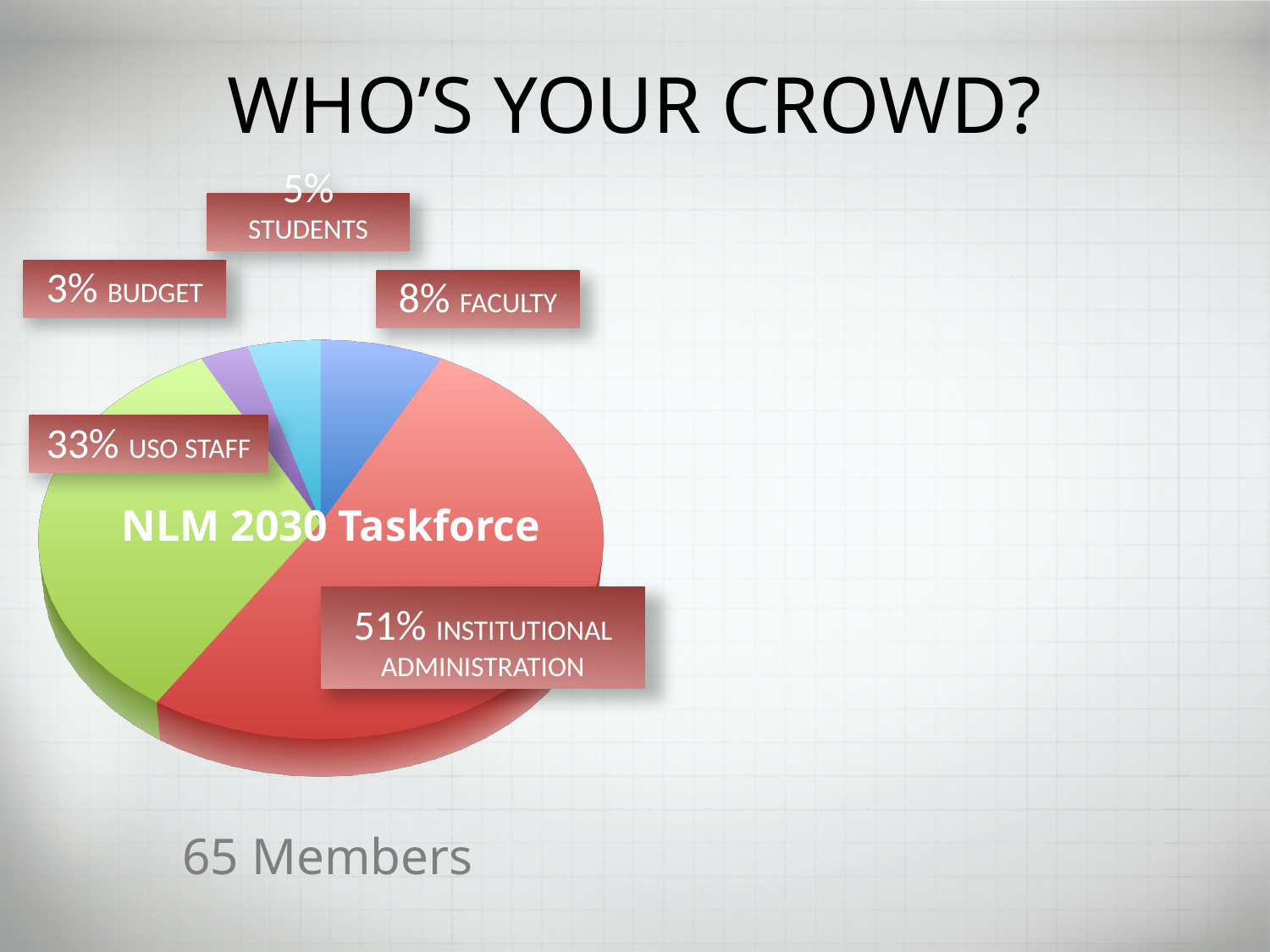
What is the difference in percentage points between Institutional Administration and USO Staff? 18 Which category has the largest slice of the pie? Institutional Administration Which is larger, the Faculty slice or the Students slice? Faculty What share of the pie is Budget? 3% How many categories are shown in the pie chart? 5 What share of the pie is Faculty? 8% What share of the pie is Students? 5% Which category has the smallest slice of the pie? Budget What is the name of the group shown in the pie chart? NLM 2030 Taskforce What kind of chart is shown on the slide? Pie chart